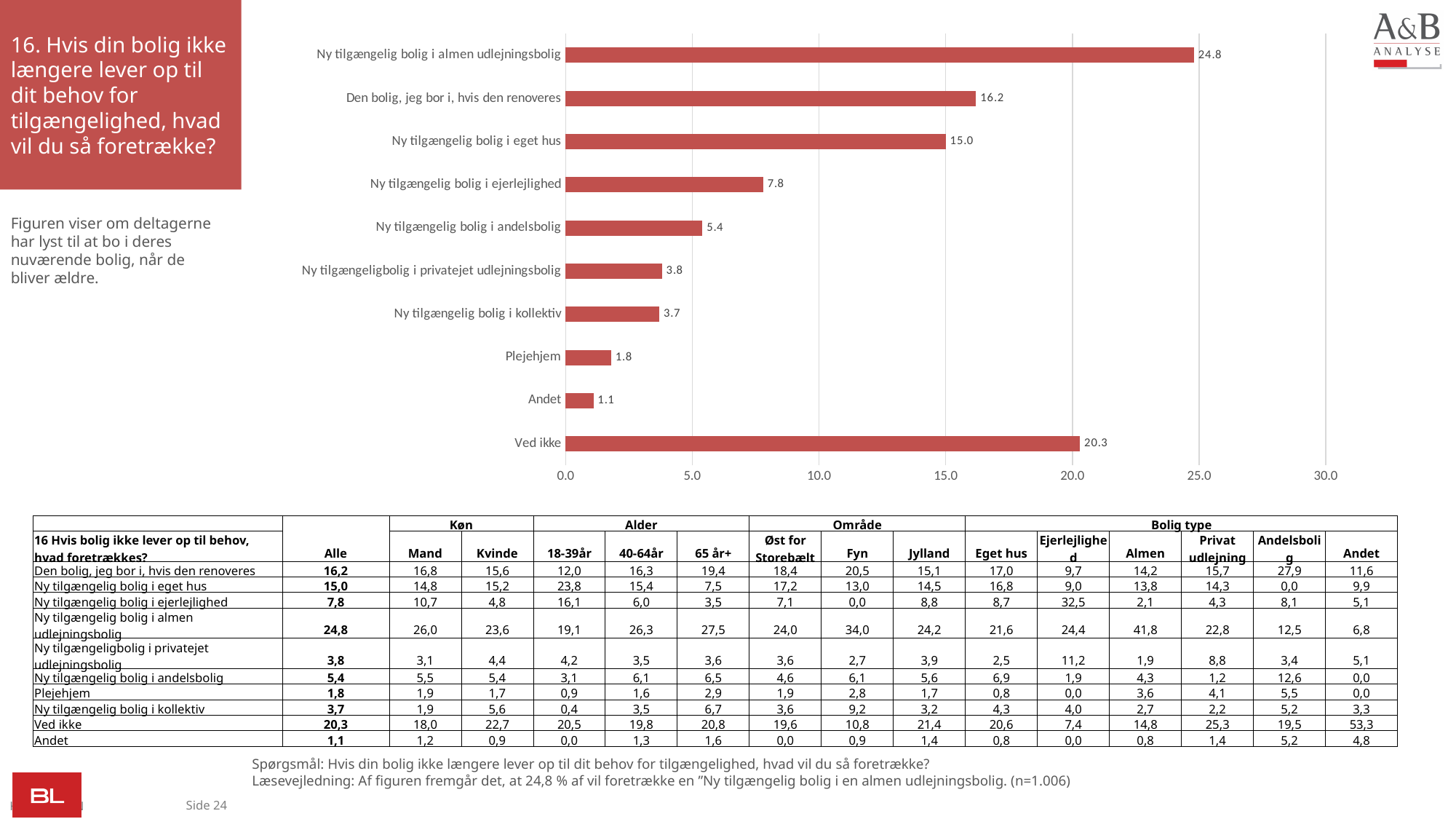
Which is larger: "Ved ikke" or "Den bolig, jeg bor i, hvis den renoveres"? Ved ikke Which category has the lowest value? Andet What is the maximum value shown on the x axis? 30.0 What is the value for "Plejehjem"? 1.8 Is the value for "Ny tilgængelig bolig i ejerlejlighed" greater or less than 5.0? greater What is the difference between "Den bolig, jeg bor i, hvis den renoveres" and "Ny tilgængelig bolig i eget hus"? 1.2 What is the value for "Ny tilgængelig bolig i almen udlejningsbolig"? 24.8 What kind of chart is shown on the slide? Bar chart How many categories are shown in the chart? 10 What is the value for "Ved ikke"? 20.3 What is the difference between "Ny tilgængelig bolig i almen udlejningsbolig" and "Ved ikke"? 4.5 Which category has the highest value? Ny tilgængelig bolig i almen udlejningsbolig